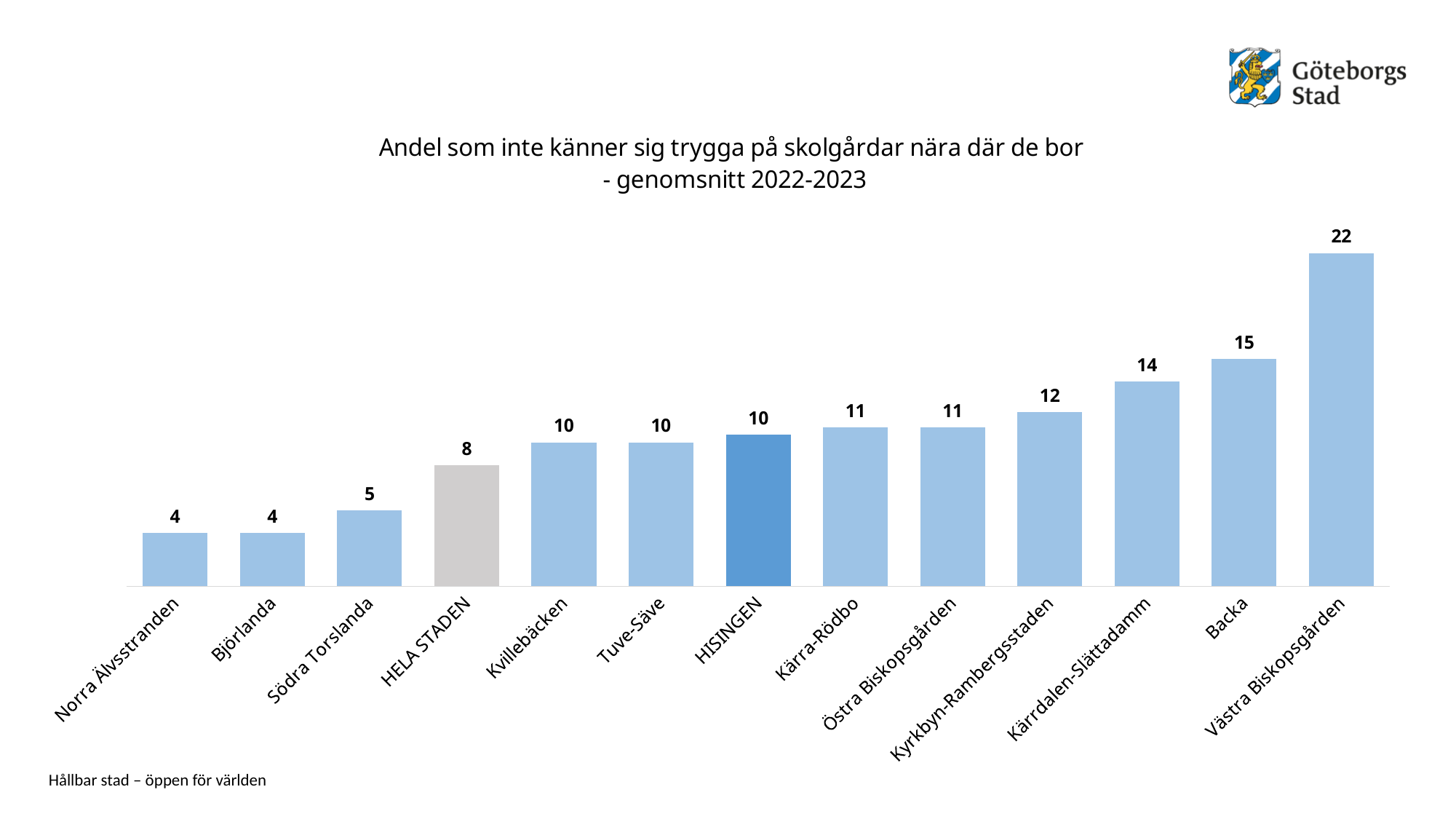
What is the value for HELA STADEN? 8 What is the difference between the values for Västra Biskopsgården and HISINGEN? 12 Which is larger, the value for Kyrkbyn-Rambergsstaden or the value for Kvillebäcken? Kyrkbyn-Rambergsstaden What is the value for Kärrdalen-Slättadamm? 14 What is the difference between the values for Backa and Södra Torslanda? 10 What is the value for HISINGEN? 10 What kind of chart is shown on the slide? Bar chart How many categories are shown on the x axis? 13 Which category has the highest value? Västra Biskopsgården Do the values generally rise or fall from left to right along the x axis? Rise What is the value for Västra Biskopsgården? 22 What is the title of the chart? Andel som inte känner sig trygga på skolgårdar nära där de bor - genomsnitt 2022-2023